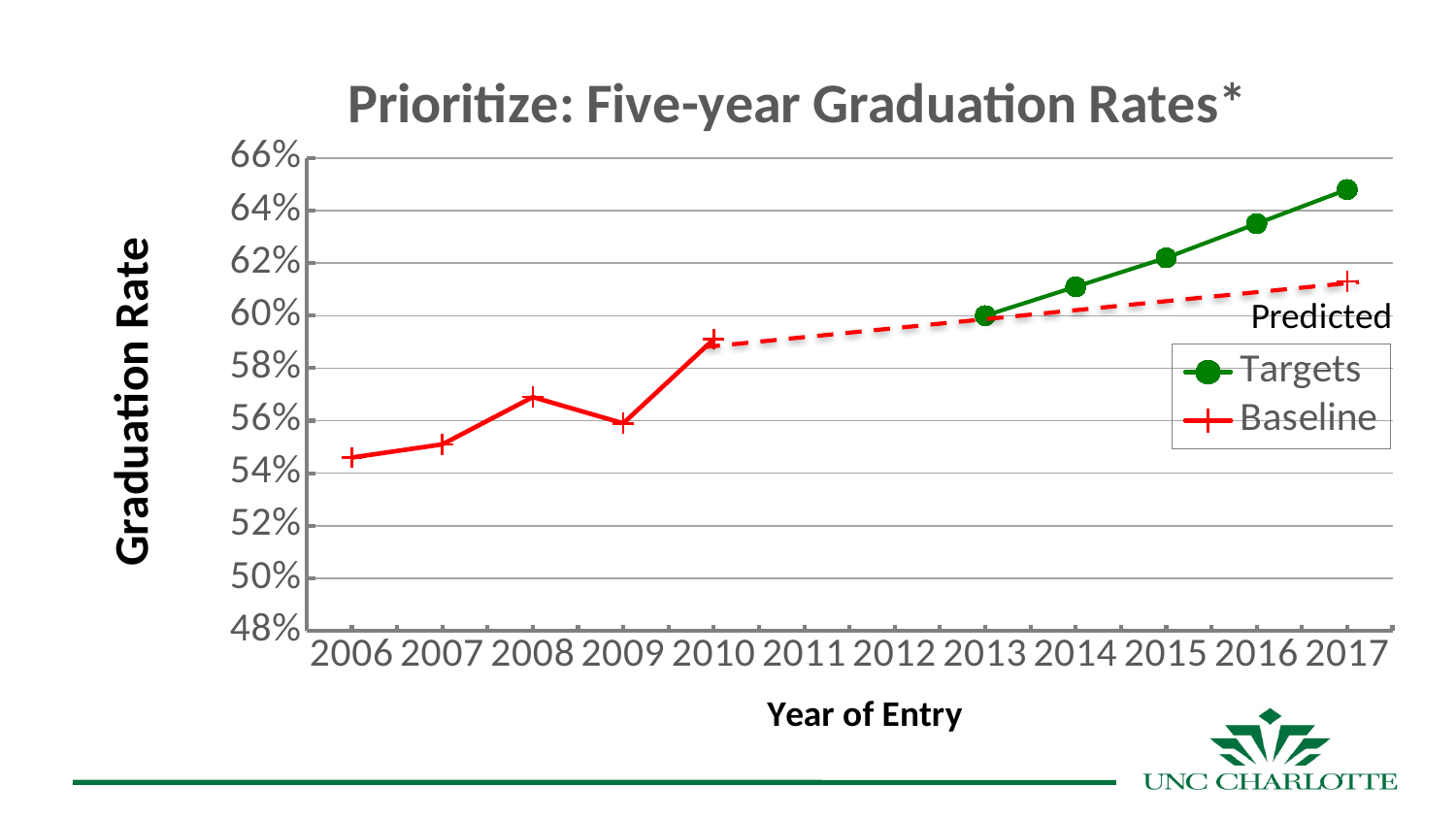
How many data points does the Targets series have? 5 Is the Baseline value for 2010 greater or less than 60%? less Do the Targets values rise or fall from 2013 to 2017? rise Is the Targets value for 2017 greater or less than 64%? greater Which year has the lowest Baseline graduation rate? 2006 Is the Targets value for 2016 greater or less than 62%? greater In 2017, which series has the higher graduation rate, Targets or Baseline? Targets How many series does the legend list? 2 What is the label on the x axis? Year of Entry How many years are shown on the x axis? 12 What kind of chart is shown on the slide? line chart